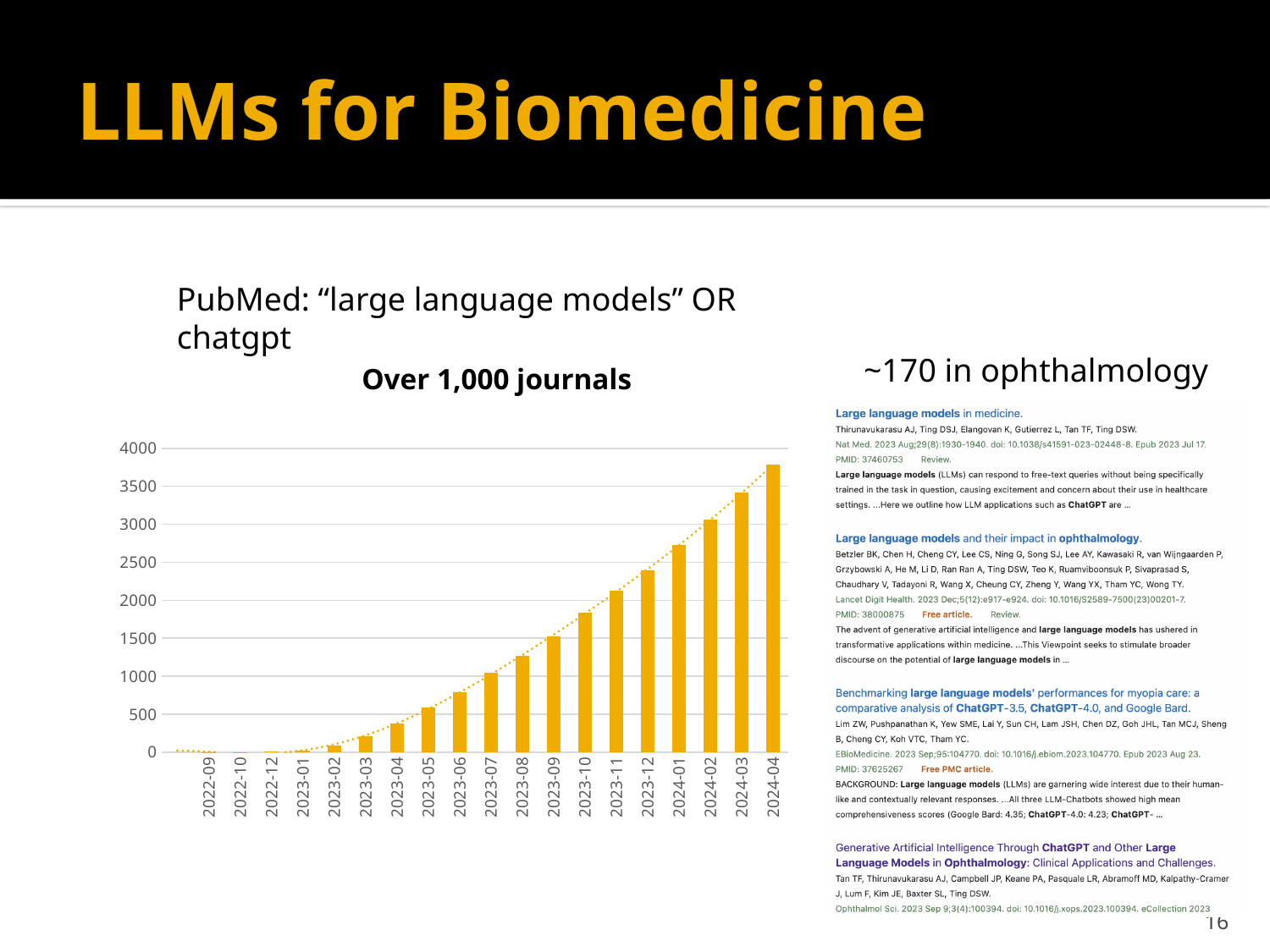
Is the value for 2024-01 greater or less than 2500? greater Is the value for 2023-10 greater or less than 1500? greater What kind of chart is shown on the slide? bar chart What is the title of the chart? Over 1,000 journals Is the value for 2024-04 greater or less than 3500? greater What colour are the bars in the chart? yellow-orange Do the values rise or fall from 2022-09 to 2024-04? rise Which is larger, the value for 2024-03 or the value for 2023-12? 2024-03 Which month has the highest bar in the chart? 2024-04